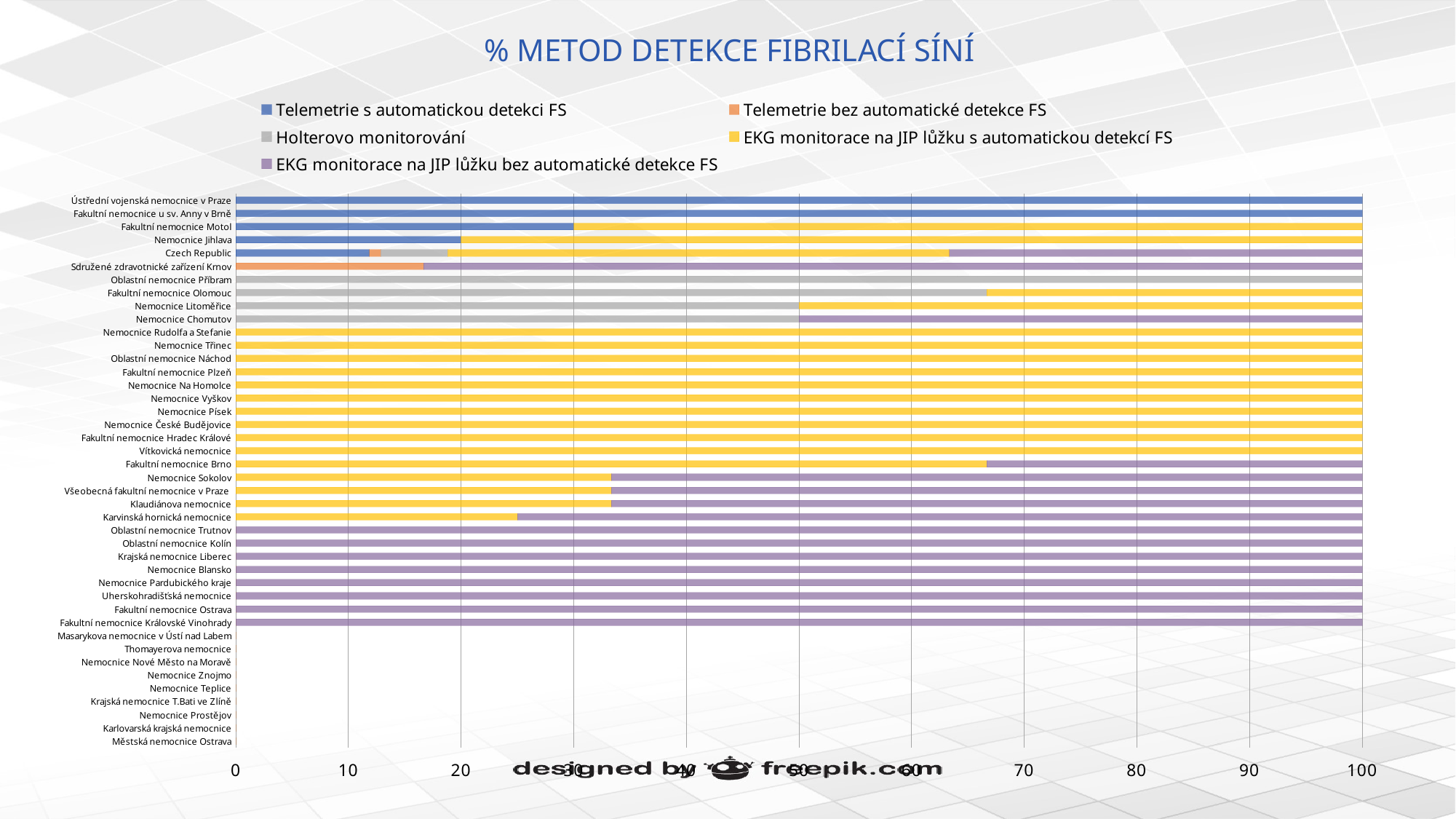
Is the value of 'Telemetrie bez automatické detekce FS' for Sdružené zdravotnické zařízení Krnov greater or less than 10? greater Which has the larger 'Telemetrie s automatickou detekci FS' value, Fakultní nemocnice Motol or Nemocnice Jihlava? Fakultní nemocnice Motol Is the value of 'Holterovo monitorování' for Fakultní nemocnice Olomouc greater or less than 60? greater What is the title of the chart? % METOD DETEKCE FIBRILACÍ SÍNÍ How many series does the legend list? 5 What is the value of 'Telemetrie s automatickou detekci FS' for Nemocnice Jihlava? 20 Which has the larger 'EKG monitorace na JIP lůžku s automatickou detekcí FS' value, Nemocnice Sokolov or Karvinská hornická nemocnice? Nemocnice Sokolov What is the value of 'Telemetrie s automatickou detekci FS' for Ústřední vojenská nemocnice v Praze? 100 What kind of chart is shown on the slide? Stacked bar chart Is the value of 'Telemetrie s automatickou detekci FS' for Czech Republic greater or less than 20? less What is the value of 'Holterovo monitorování' for Nemocnice Litoměřice? 50 Which series is shown in yellow in the legend? EKG monitorace na JIP lůžku s automatickou detekcí FS